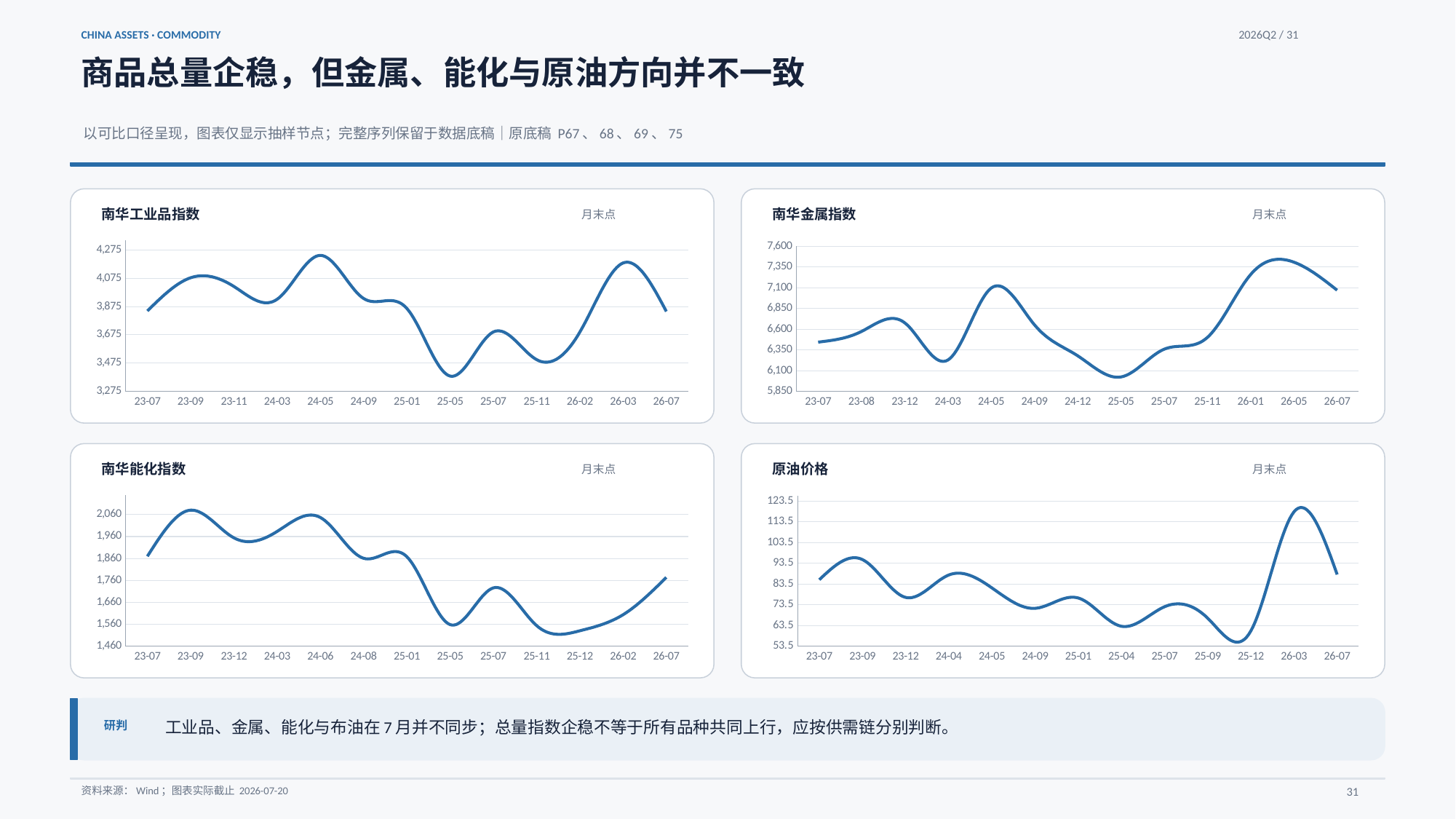
On the 原油价格 chart, which x-axis point has the highest value? 26-03 On the 原油价格 chart, is the value at 25-12 greater or less than 63.5? less On the 南华工业品指数 chart, is the value at 25-05 greater or less than 3,475? less On the 南华金属指数 chart, which x-axis point has the lowest value? 25-05 On the 原油价格 chart, does the value rise or fall from 25-12 to 26-03? rise On the 南华工业品指数 chart, which x-axis point has the lowest value? 25-05 What kind of chart is the 南华工业品指数 chart? line chart On the 南华能化指数 chart, is the value at 25-12 greater or less than 1,560? less How many x-axis points are shown on the 南华工业品指数 chart? 13 On the 南华金属指数 chart, which x-axis point has the highest value? 26-05